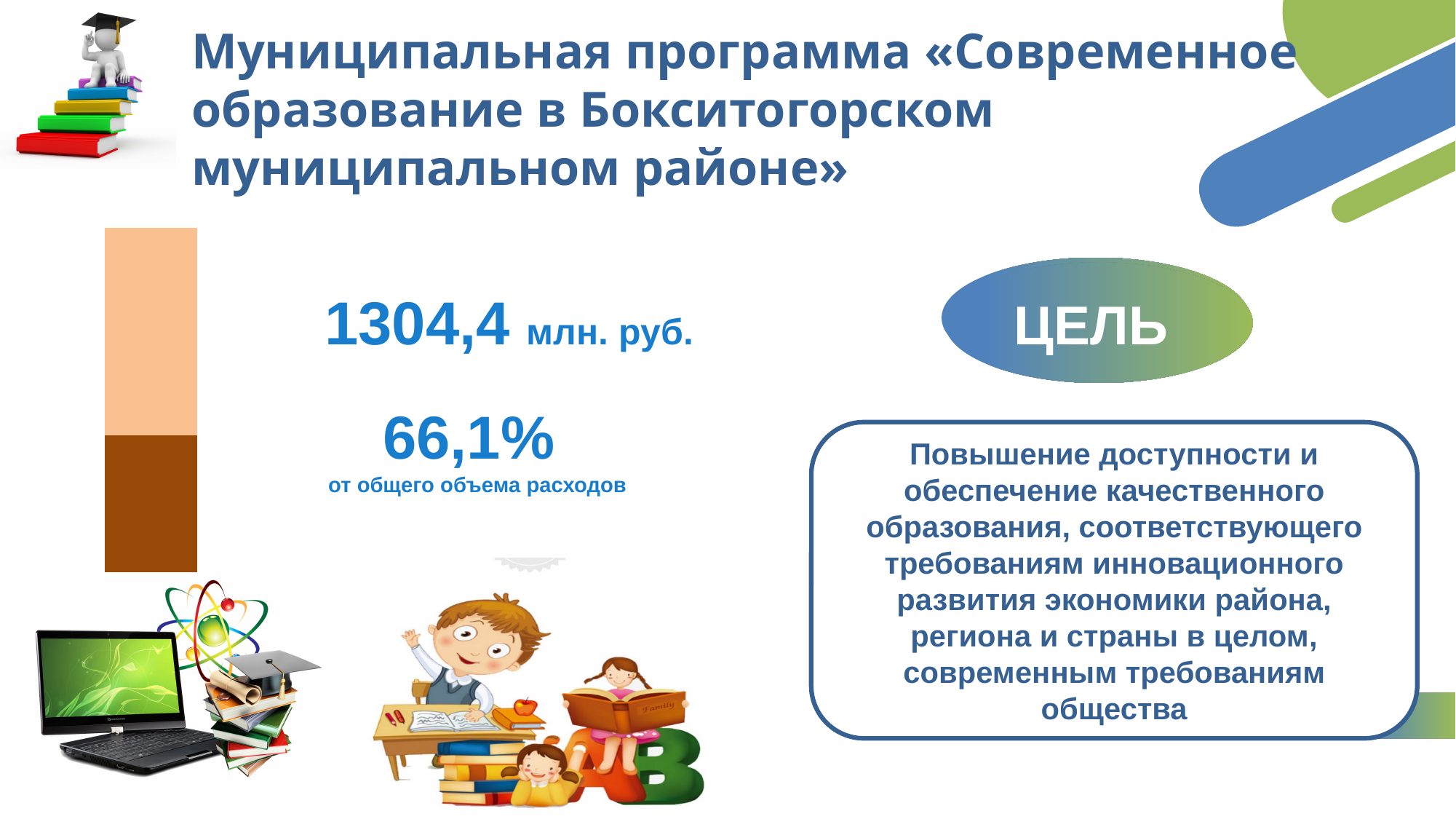
What percentage of total expenditure (от общего объема расходов) is printed next to the bar chart? 66,1% What colour is the top segment of the stacked bar? light orange What colour is the bottom segment of the stacked bar? brown Which segment of the stacked bar is taller, the light orange one or the brown one? light orange What kind of chart is shown on the left of the slide? bar chart How many segments does the stacked bar on the left of the slide have? 2 What amount in million rubles is printed next to the bar chart? 1304,4 млн. руб.